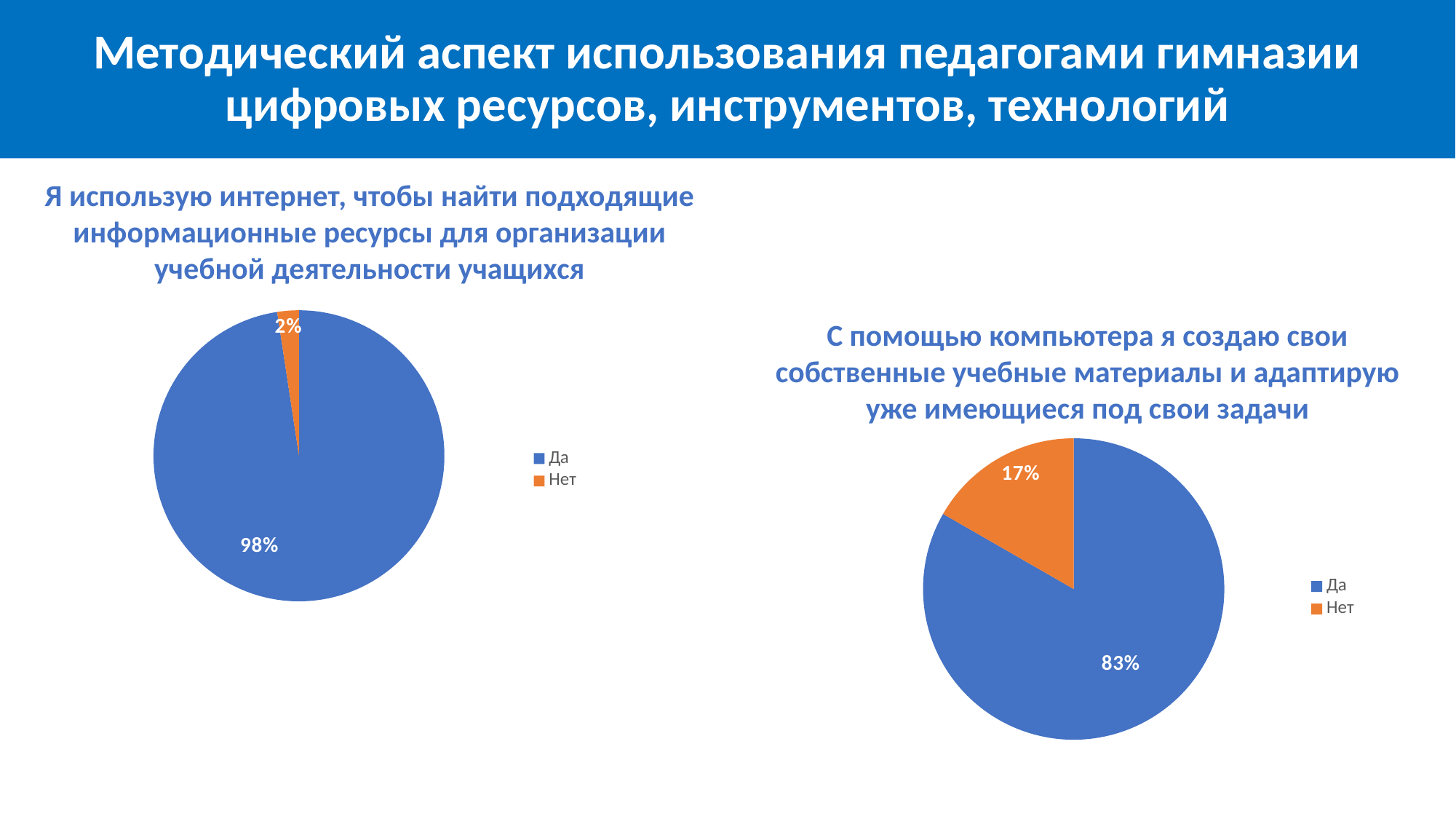
What type of chart is used on the left side of the slide? Pie chart In the right pie chart, what colour is the "Нет" slice? Orange In the right pie chart, what is the difference between the "Да" and "Нет" shares? 66% In the left pie chart, what share of respondents answered "Нет"? 2% In the right pie chart, which answer has the smallest slice? Нет In the right pie chart, what share of respondents answered "Нет"? 17% In the left pie chart, what share of respondents answered "Да"? 98% In the left pie chart, which answer has the largest slice? Да Which chart has the larger "Нет" share, the left one or the right one? The right one In the right pie chart, what share of respondents answered "Да"? 83% How many entries does the legend of the left pie chart list? 2 How many slices does the right pie chart have? 2